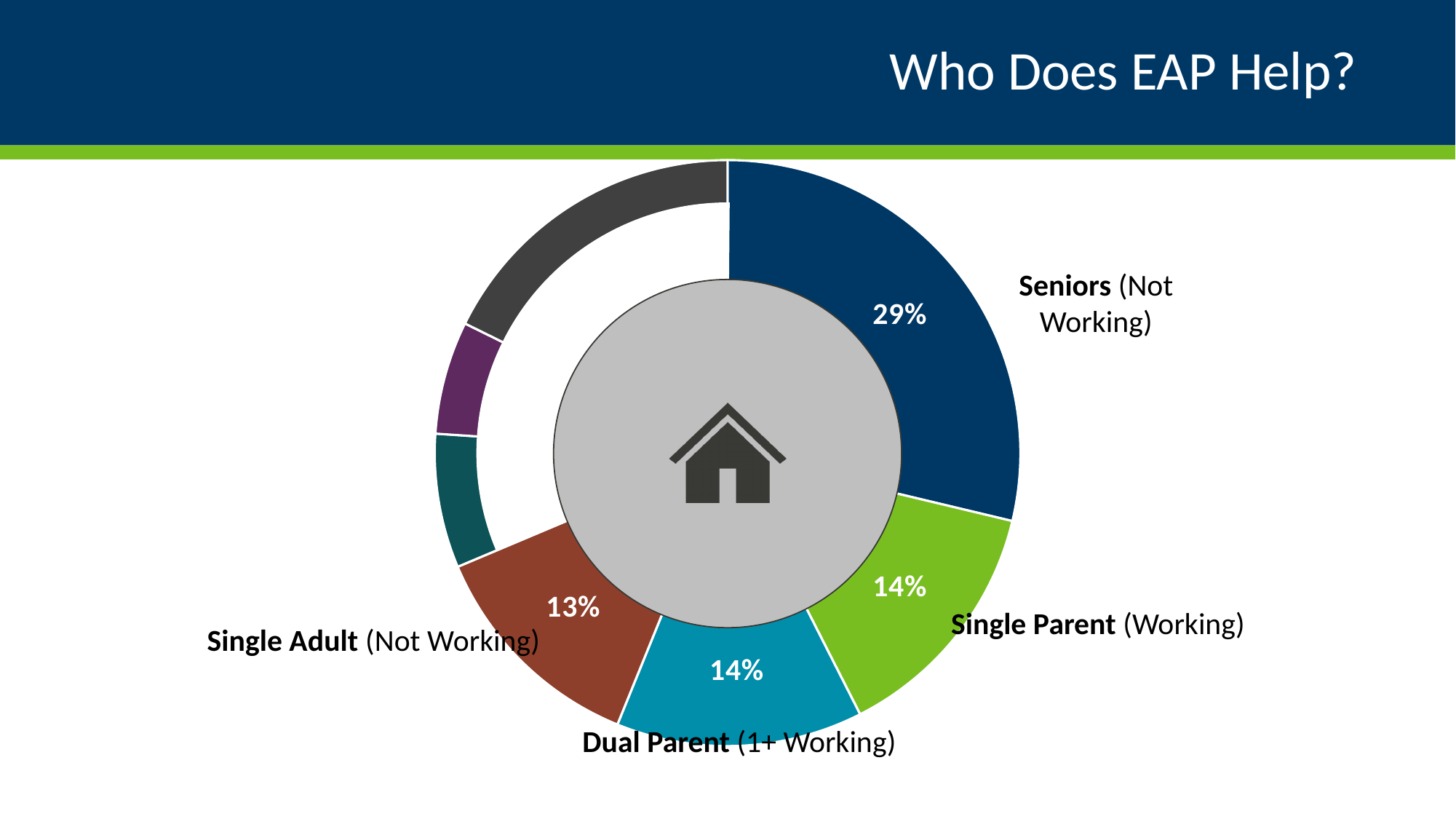
How many slices does the pie chart have in total? 7 What percentage is shown for Single Parent (Working)? 14% What colour is the Seniors (Not Working) slice? Dark blue Which category has the largest share of the pie chart? Seniors (Not Working) What percentage of the pie chart is Seniors (Not Working)? 29% Which is larger, the share for Seniors (Not Working) or the share for Single Adult (Not Working)? Seniors (Not Working) What percentage is shown for Dual Parent (1+ Working)? 14% What is the difference in percentage points between Dual Parent (1+ Working) and Single Adult (Not Working)? 1 What is the difference in percentage points between Seniors (Not Working) and Single Parent (Working)? 15 What percentage is shown for Single Adult (Not Working)? 13% What is the title of the slide? Who Does EAP Help? What type of chart is shown on the slide? Doughnut chart